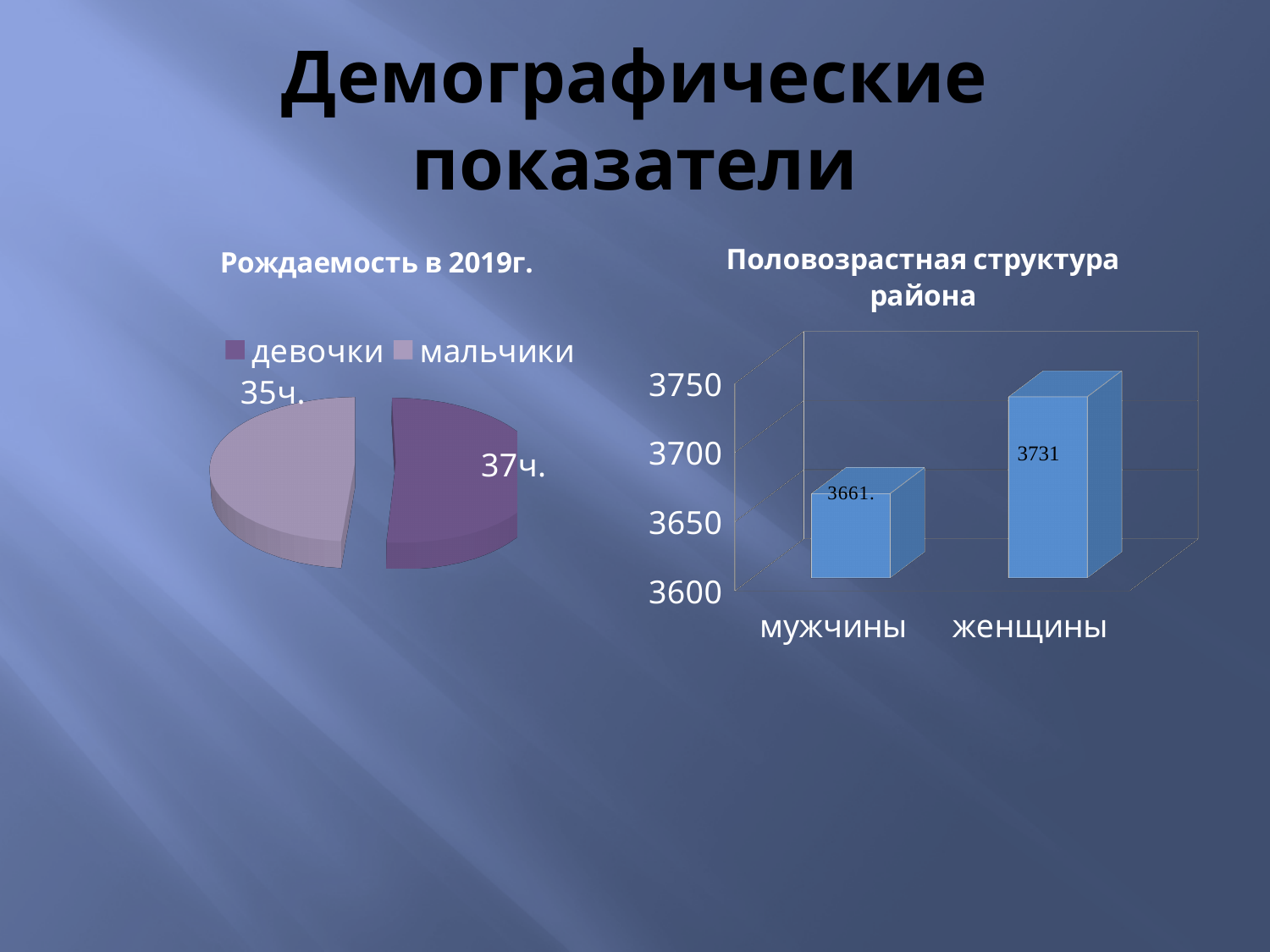
In the chart titled 'Половозрастная структура района', what is the difference between the values for женщины and мужчины? 70 In the chart titled 'Рождаемость в 2019г.', what is the value for девочки? 37ч. In the chart titled 'Половозрастная структура района', what is the value for мужчины? 3661 What kind of chart is the one titled 'Рождаемость в 2019г.'? pie chart In the chart titled 'Рождаемость в 2019г.', what is the difference between the values for девочки and мальчики? 2ч. In the chart titled 'Половозрастная структура района', is the value for мужчины greater or less than 3700? less In the chart titled 'Рождаемость в 2019г.', what is the value for мальчики? 35ч. In the chart titled 'Рождаемость в 2019г.', which category has the larger value, девочки or мальчики? девочки What kind of chart is the one titled 'Половозрастная структура района'? bar chart In the chart titled 'Половозрастная структура района', what is the value for женщины? 3731 How many entries does the legend of the chart titled 'Рождаемость в 2019г.' list? 2 In the chart titled 'Половозрастная структура района', which category has the highest value? женщины